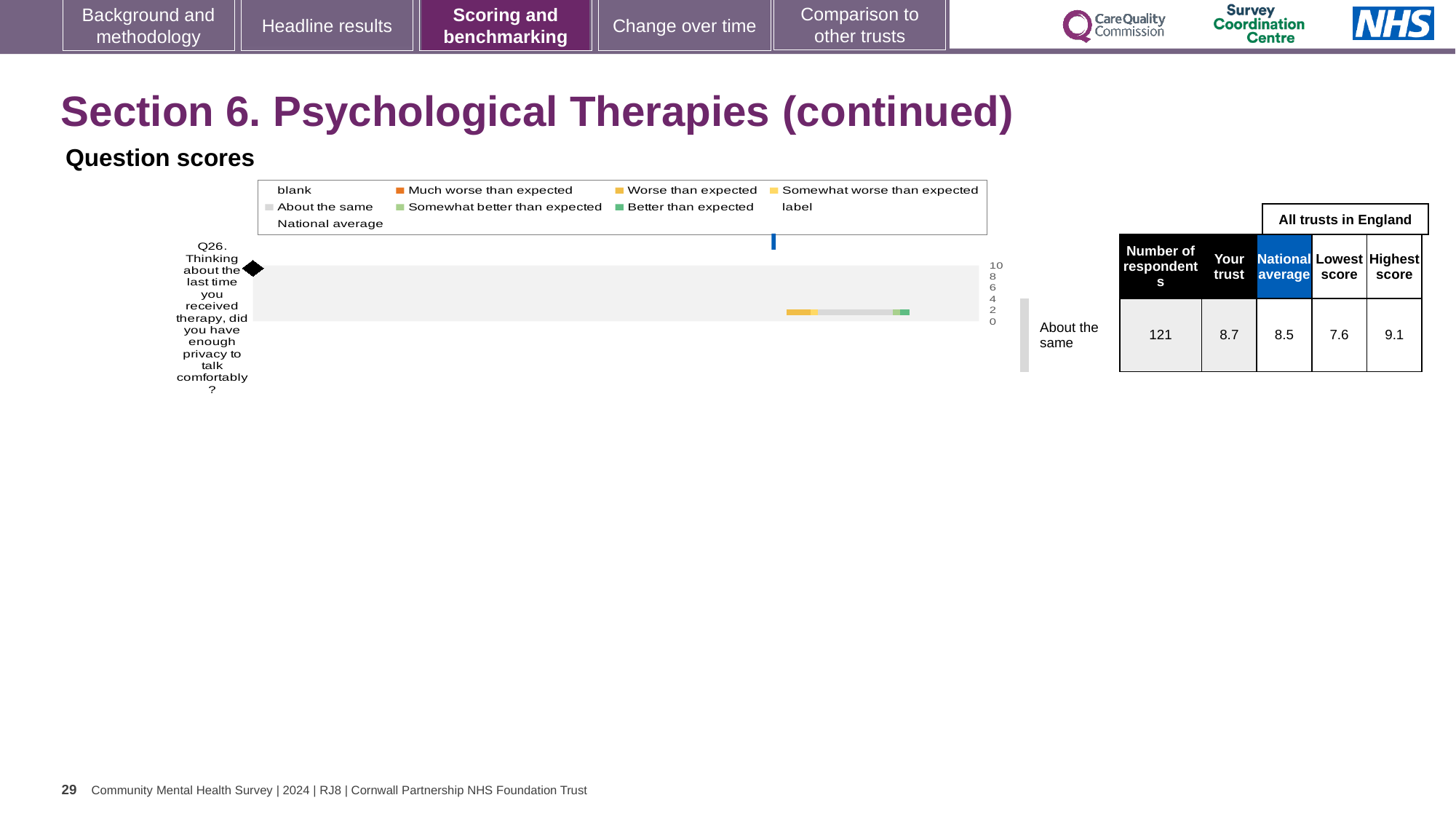
What is the highest score among all trusts in England for Q26? 9.1 What is the difference between the highest score and the lowest score for Q26? 1.5 What kind of chart is used to show the question scores on this slide? bar chart What is the 'Your trust' score for Q26? 8.7 What benchmark category is given for Q26 next to the chart? About the same How many respondents answered Q26? 121 What is the lowest score among all trusts in England for Q26? 7.6 Which is larger for Q26, the 'Your trust' score or the national average? Your trust What is the difference between the 'Your trust' score and the national average for Q26? 0.2 How many questions are plotted in the question scores chart? 1 Which question is shown in the question scores chart? Q26. Thinking about the last time you received therapy, did you have enough privacy to talk comfortably? What is the national average score for Q26? 8.5